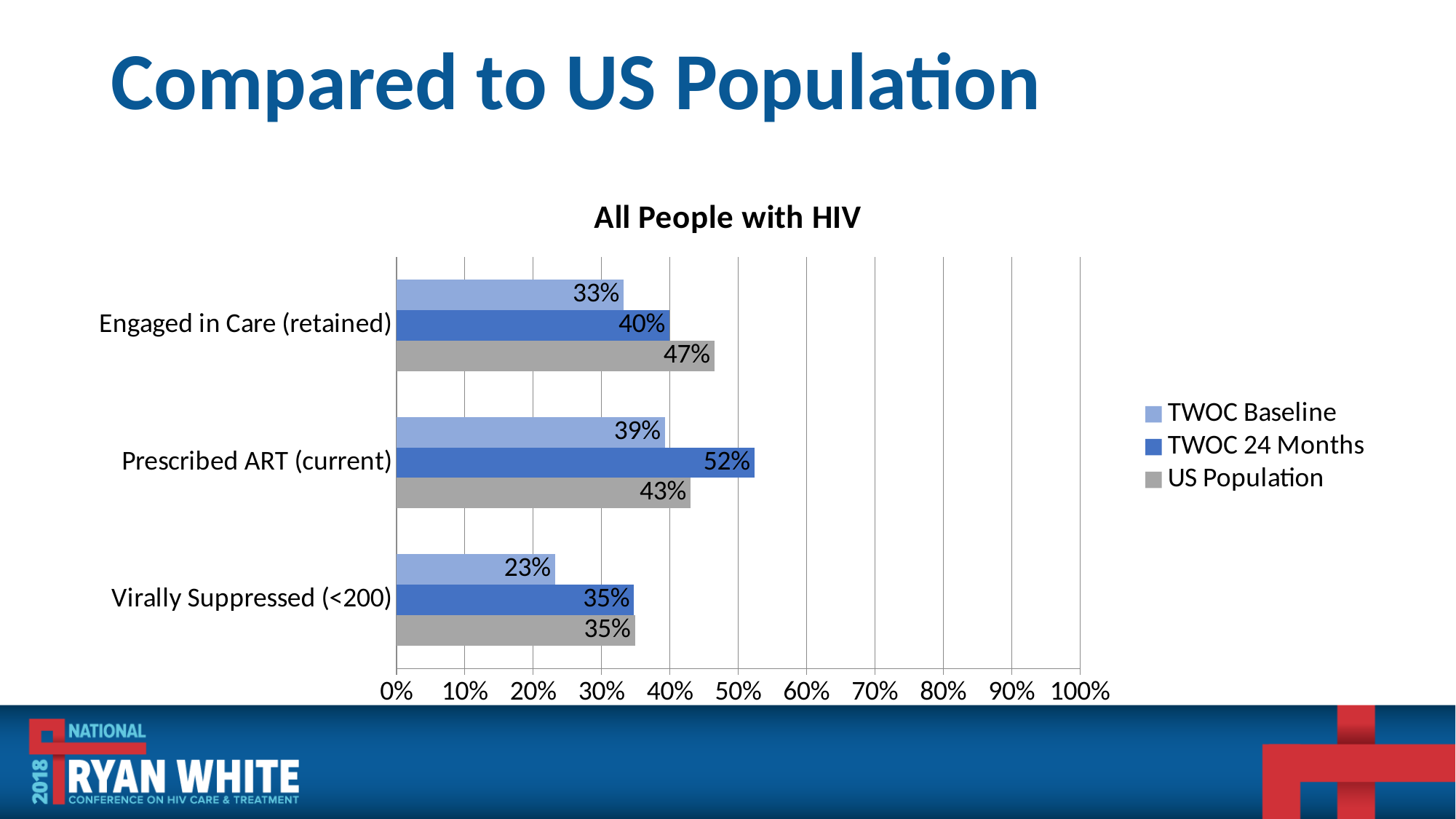
Which category has the highest TWOC 24 Months value? Prescribed ART (current) How many categories are shown on the chart? 3 What is the US Population value for Engaged in Care (retained)? 47% What is the US Population value for Virally Suppressed (<200)? 35% What is the TWOC Baseline value for Engaged in Care (retained)? 33% What type of chart is shown on the slide? Bar chart How many series does the legend list? 3 What is the TWOC 24 Months value for Prescribed ART (current)? 52% Which category has the lowest TWOC Baseline value? Virally Suppressed (<200) What is the difference between the TWOC 24 Months and TWOC Baseline values for Virally Suppressed (<200)? 12% Is the TWOC 24 Months value for Prescribed ART (current) greater or less than 50%? greater For Engaged in Care (retained), which is larger: the TWOC 24 Months value or the US Population value? US Population